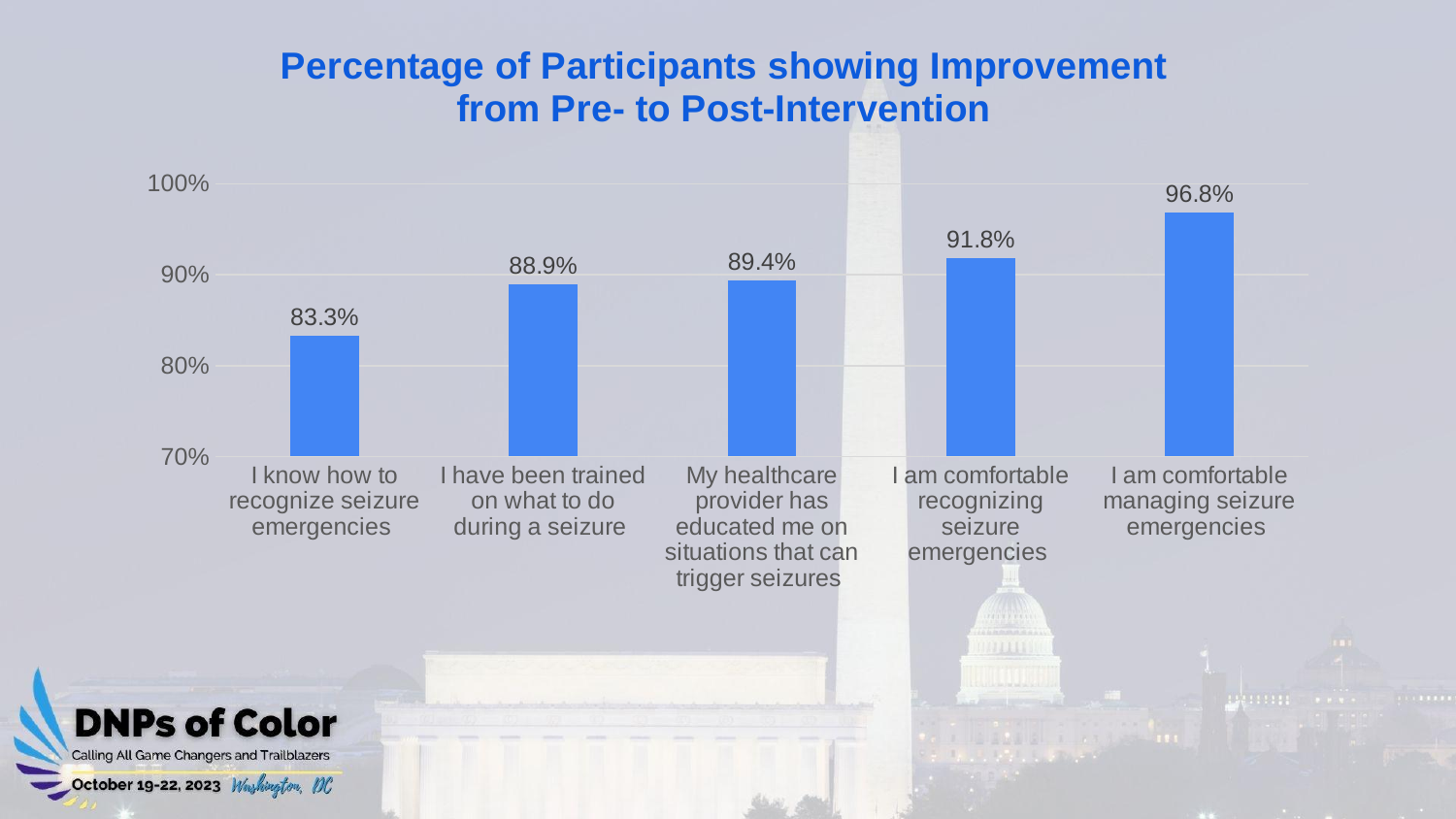
Which category has the lowest percentage of participants showing improvement? I know how to recognize seizure emergencies What is the value for "I am comfortable managing seizure emergencies"? 96.8% How many categories are shown in the chart? 5 What kind of chart is shown on the slide? Bar chart What percentage of participants showed improvement for "I know how to recognize seizure emergencies"? 83.3% Do the values rise or fall from left to right across the categories? Rise What is the difference between the values for "I am comfortable managing seizure emergencies" and "I know how to recognize seizure emergencies"? 13.5% Which category has the highest percentage of participants showing improvement? I am comfortable managing seizure emergencies What is the title of the chart? Percentage of Participants showing Improvement from Pre- to Post-Intervention Is the value for "I know how to recognize seizure emergencies" greater or less than 90%? less What is the value for "My healthcare provider has educated me on situations that can trigger seizures"? 89.4% Which is larger: the value for "I am comfortable recognizing seizure emergencies" or the value for "I have been trained on what to do during a seizure"? I am comfortable recognizing seizure emergencies